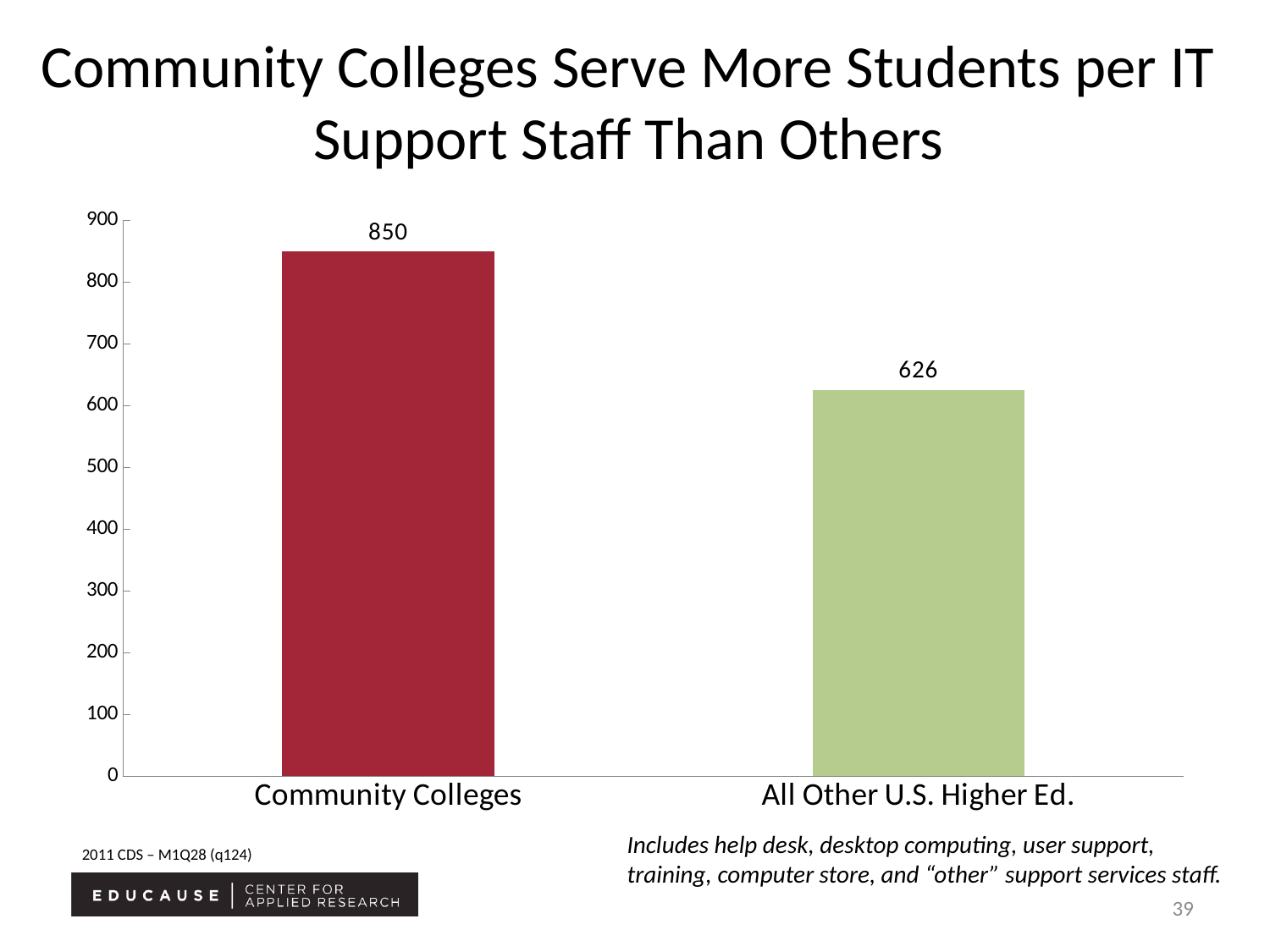
Which is larger, the value for Community Colleges or the value for All Other U.S. Higher Ed.? Community Colleges What is the difference between the values for Community Colleges and All Other U.S. Higher Ed.? 224 What is the highest value shown on the vertical axis? 900 What is the title of the slide? Community Colleges Serve More Students per IT Support Staff Than Others Is the value for Community Colleges greater or less than 800? greater Which category has the lowest value? All Other U.S. Higher Ed. How many categories are shown on the chart? 2 What kind of chart is shown on the slide? bar chart Which category has the highest value? Community Colleges What is the value for Community Colleges? 850 What is the value for All Other U.S. Higher Ed.? 626 Is the value for All Other U.S. Higher Ed. greater or less than 700? less